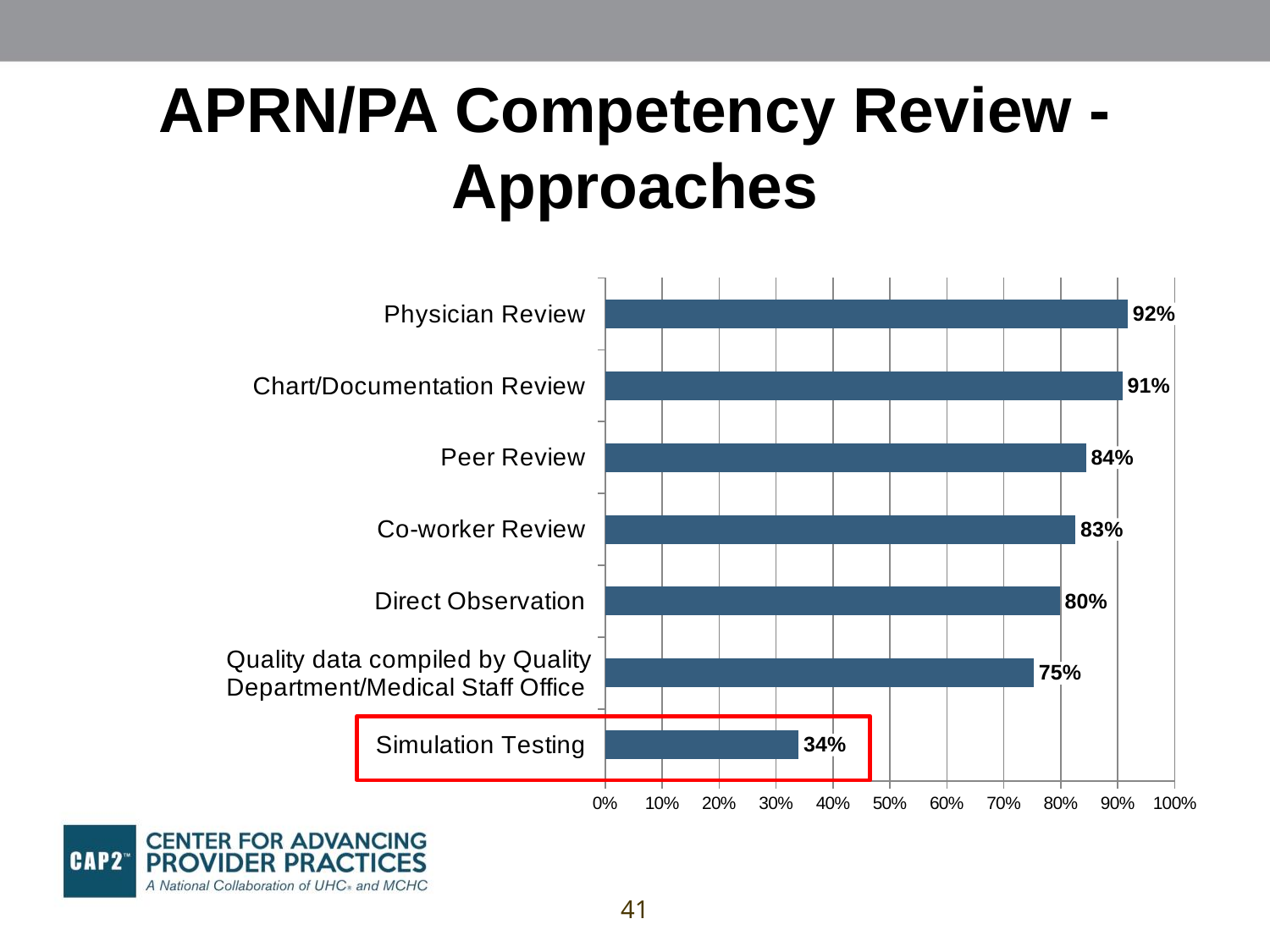
Which approach has the highest value? Physician Review What is the value for Physician Review? 92% What is the value for Simulation Testing? 34% How many approaches are shown in the chart? 7 What is the difference between the values for Peer Review and Co-worker Review? 1% What is the difference between the values for Physician Review and Simulation Testing? 58% Which category is highlighted with a red box? Simulation Testing What is the value for Direct Observation? 80% Which is larger, the value for Direct Observation or the value for Quality data compiled by Quality Department/Medical Staff Office? Direct Observation What is the value for Quality data compiled by Quality Department/Medical Staff Office? 75% What kind of chart is shown on the slide? Bar chart Which approach has the lowest value? Simulation Testing